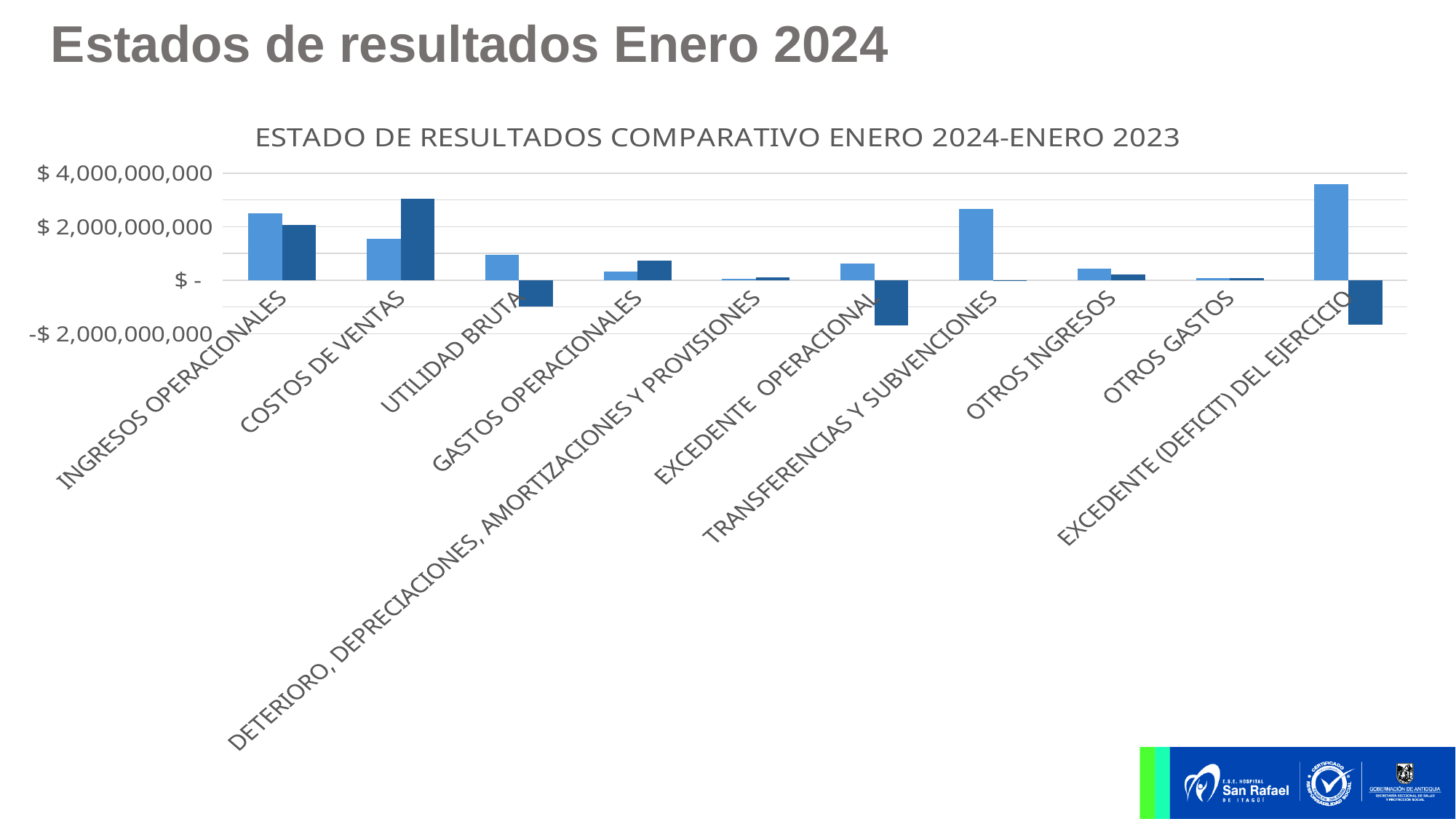
How many categories are shown on the x axis of the chart? 10 How many bars (series) are plotted for each category in the chart? 2 For COSTOS DE VENTAS, which bar is taller, the light blue or the dark blue one? dark blue What type of chart is shown on the slide? bar chart What is the title of the chart? ESTADO DE RESULTADOS COMPARATIVO ENERO 2024-ENERO 2023 Which category has the highest dark blue bar? COSTOS DE VENTAS Is the dark blue bar for UTILIDAD BRUTA above or below zero ($ -)? below Which category has the highest light blue bar? EXCEDENTE (DEFICIT) DEL EJERCICIO For INGRESOS OPERACIONALES, which bar is taller, the light blue or the dark blue one? light blue Is the light blue bar for COSTOS DE VENTAS greater or less than $ 2,000,000,000? less Is the dark blue bar for COSTOS DE VENTAS greater or less than $ 2,000,000,000? greater